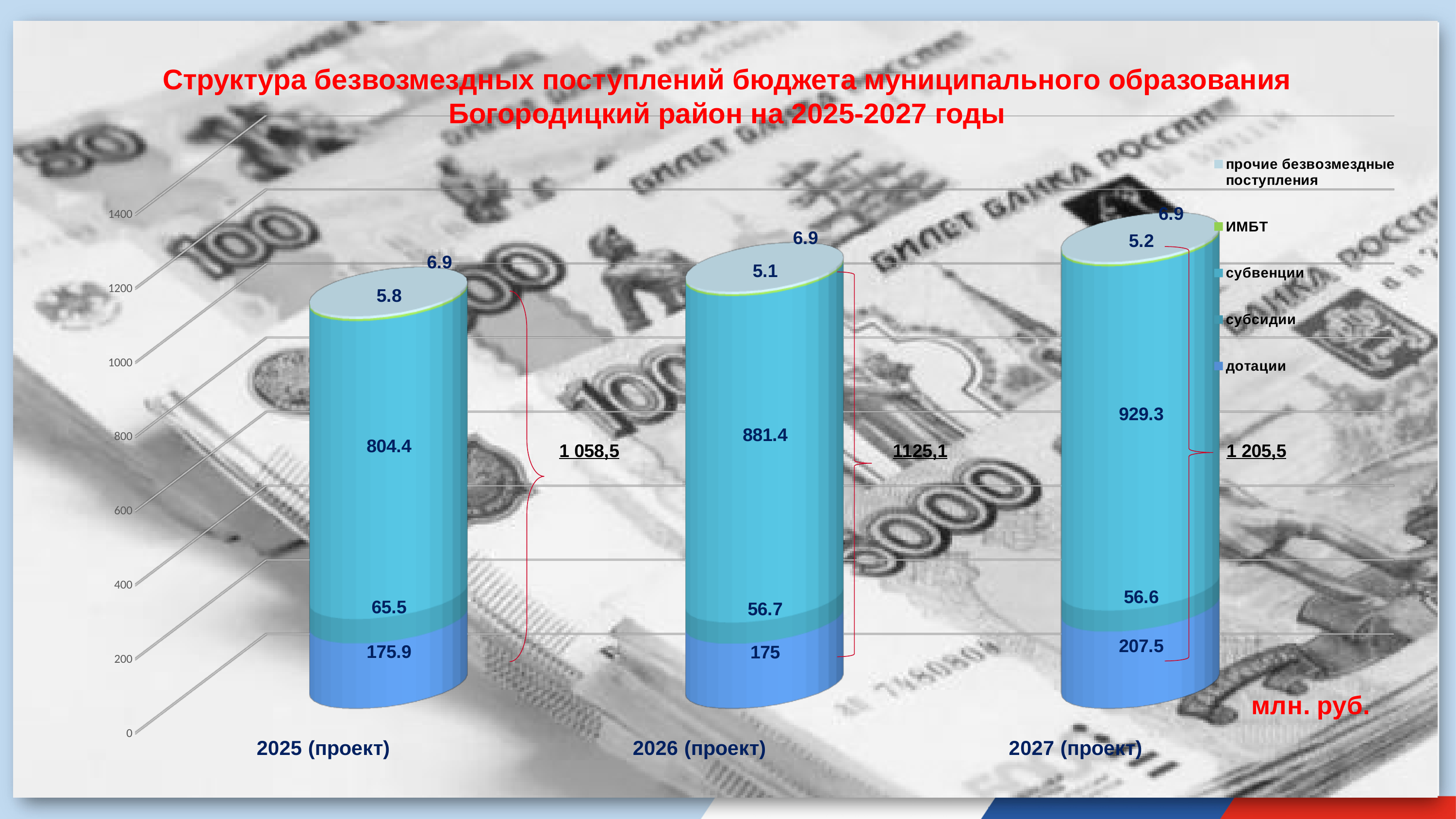
What is the value for дотации in 2027 (проект)? 207.5 What is the value for ИМБТ in 2026 (проект)? 5.1 Which is larger: субсидии in 2025 (проект) or субсидии in 2027 (проект)? 2025 (проект) What is the value for субсидии in 2026 (проект)? 56.7 What is the total shown for the 2027 (проект) bar? 1 205,5 How many series does the legend list? 5 What is the difference between the субвенции values for 2027 (проект) and 2025 (проект)? 124.9 Which year has the lowest value for дотации? 2026 (проект) What kind of chart is shown on the slide? stacked bar chart Which year has the highest value for субвенции? 2027 (проект) What is the value for субвенции in 2025 (проект)? 804.4 Do the субвенции values rise or fall from 2025 to 2027? rise